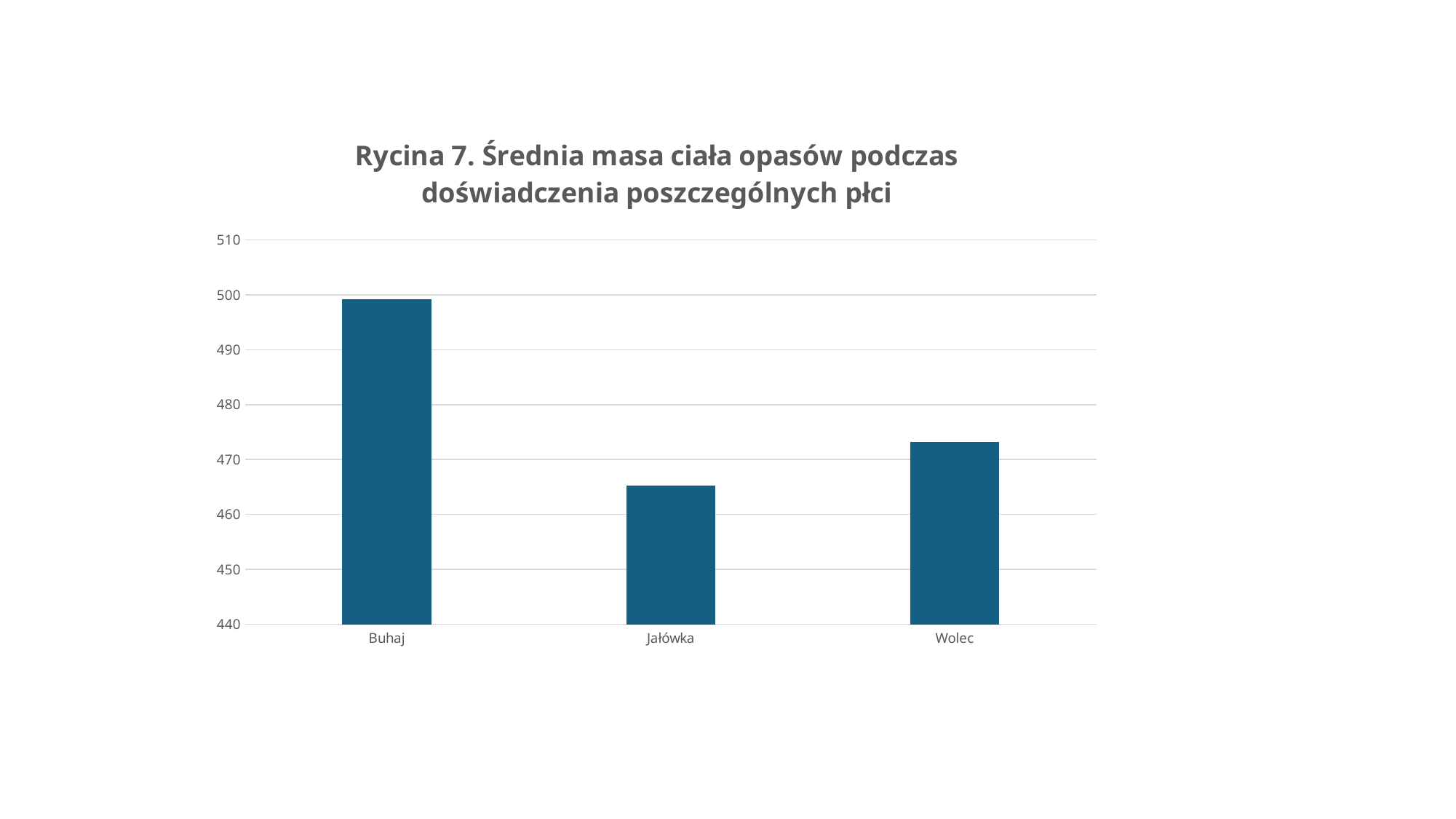
Which category has the highest value? Buhaj What is the title of the chart? Rycina 7. Średnia masa ciała opasów podczas doświadczenia poszczególnych płci Is the value for Wolec greater or less than 470? greater Is the value for Buhaj greater or less than 490? greater Is the value for Jałówka greater or less than 470? less Which is larger, the value for Wolec or the value for Jałówka? Wolec What is the lowest value shown on the y axis? 440 What type of chart is shown on the slide? bar chart Which is larger, the value for Buhaj or the value for Wolec? Buhaj Which category has the lowest value? Jałówka How many categories are shown on the x axis? 3